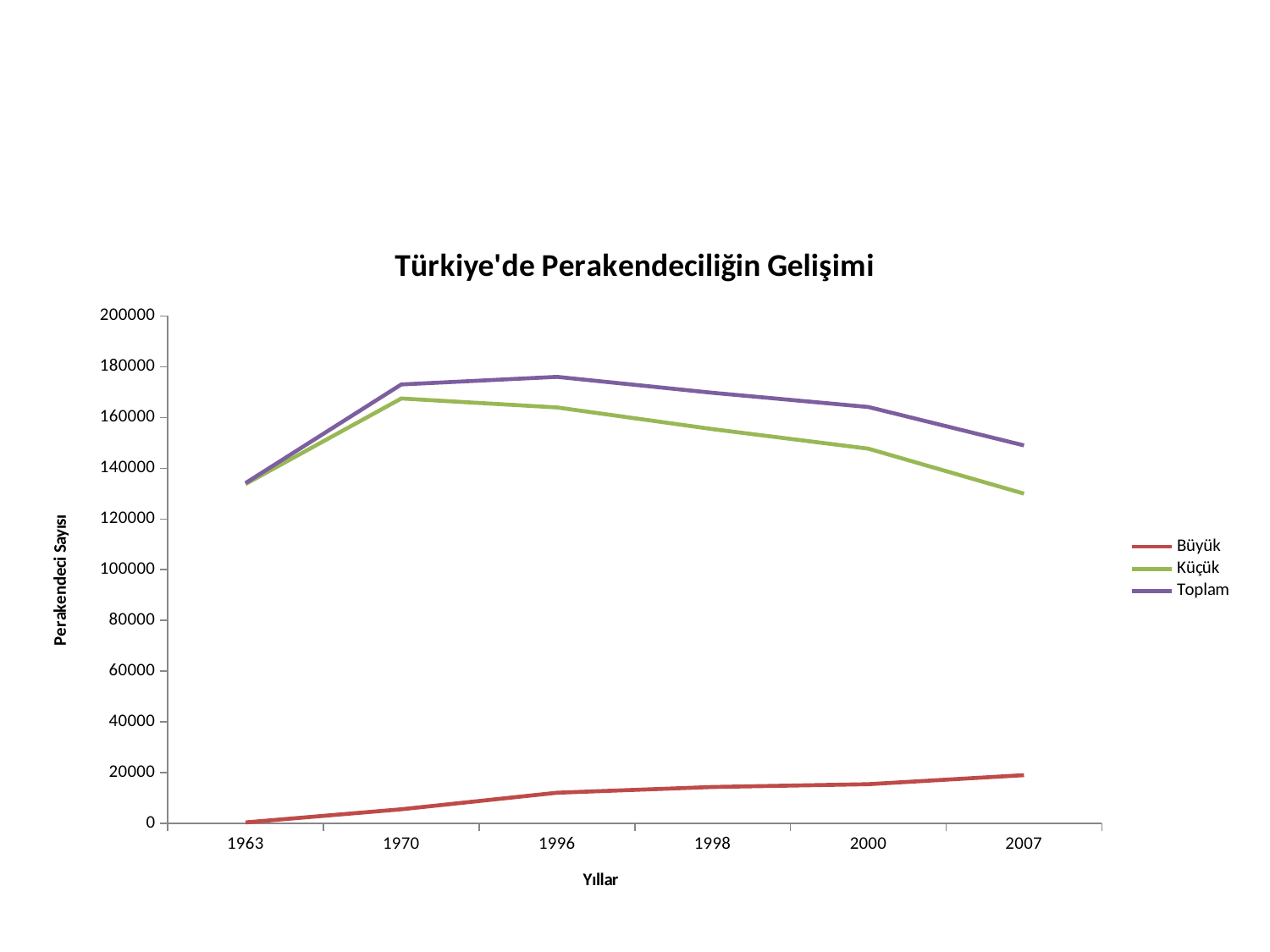
Does the Büyük series rise or fall from 1963 to 2007? rise Is the Küçük value for 2007 greater or less than 120000? greater Is the Toplam value for 1996 greater or less than 180000? less In which year is the Büyük series at its highest? 2007 Which is larger, the Toplam value in 1970 or in 2007? 1970 How many series does the legend list? 3 What is the title of the chart? Türkiye'de Perakendeciliğin Gelişimi What is the label of the y axis? Perakendeci Sayısı What kind of chart is shown on the slide? line chart How many years are plotted along the x axis? 6 In which year is the Toplam series at its lowest? 1963 Does the Küçük series rise or fall from 1970 to 2007? fall